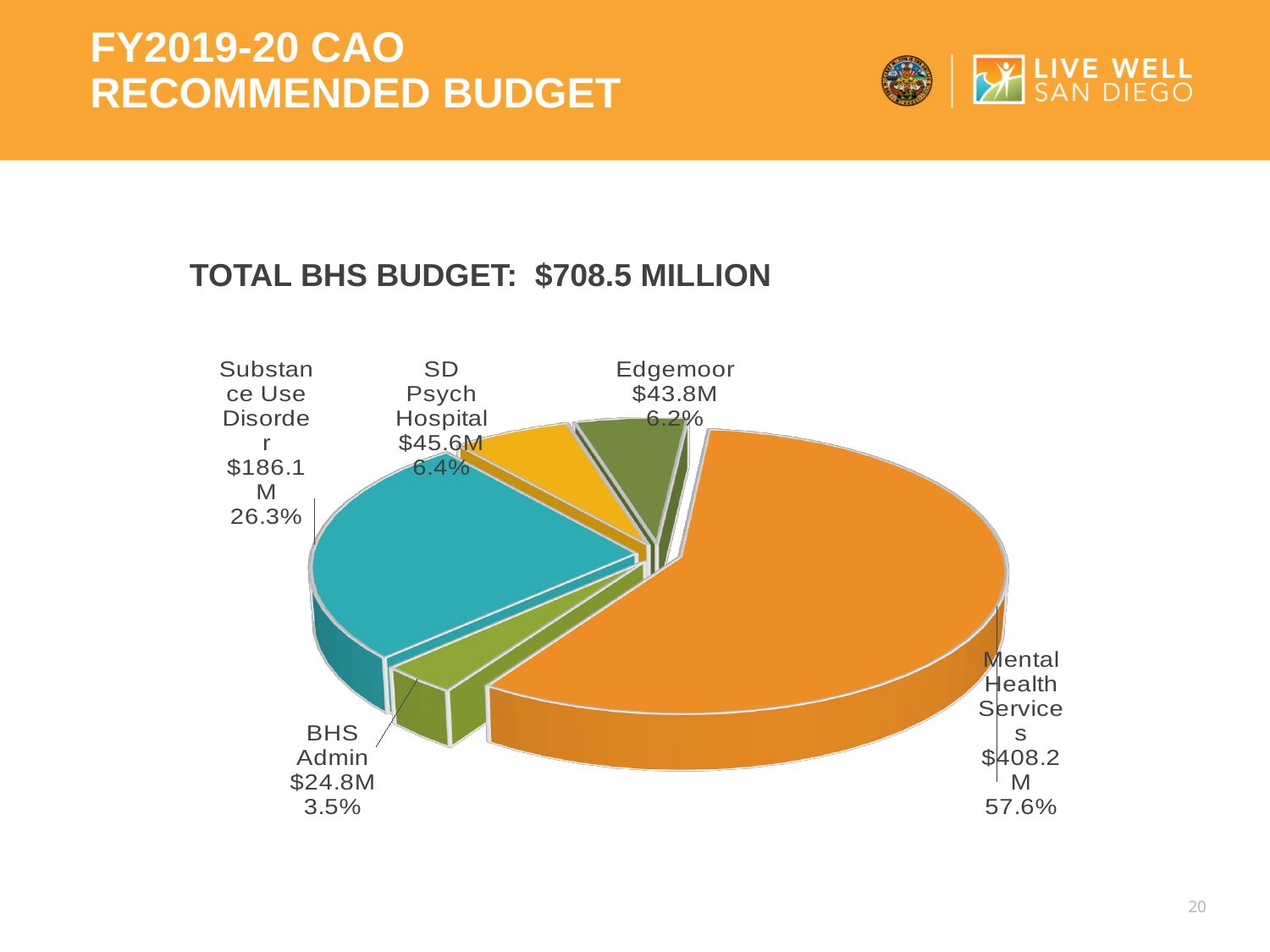
Which category has the smallest slice of the pie? BHS Admin What is the budget amount for BHS Admin? $24.8M What kind of chart is shown on the slide? Pie chart What is the budget amount for Mental Health Services? $408.2M Which has a larger budget, SD Psych Hospital or Edgemoor? SD Psych Hospital What percentage of the budget goes to Substance Use Disorder? 26.3% How many slices does the pie chart have? 5 What is the budget amount for SD Psych Hospital? $45.6M Which category has the largest slice of the pie? Mental Health Services What total BHS budget is stated above the chart? $708.5 MILLION What share of the pie does Edgemoor represent? 6.2% What is the difference in budget between Mental Health Services and Substance Use Disorder? $222.1M